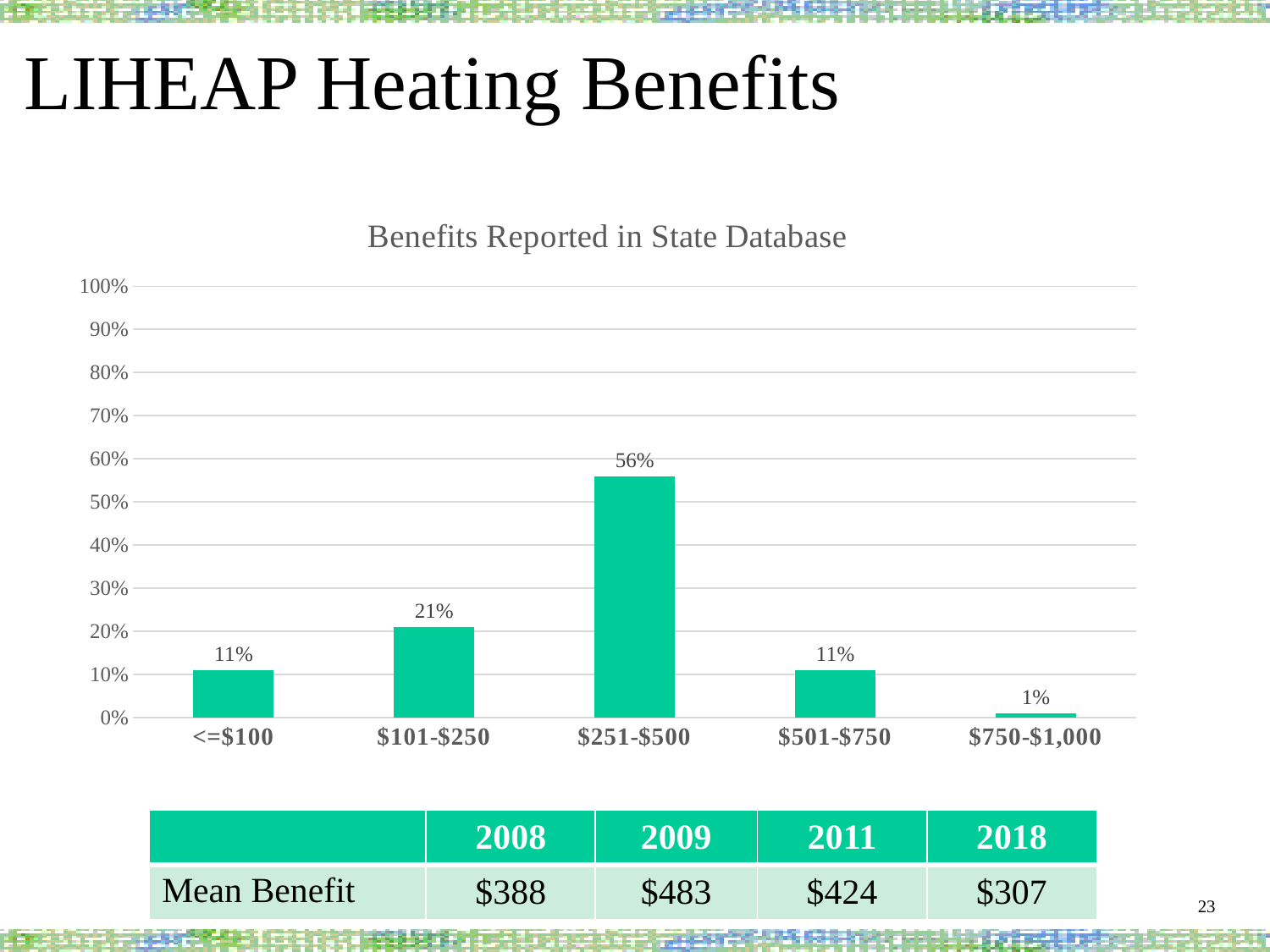
Which is larger, the value for $101-$250 or the value for $501-$750? $101-$250 Which benefit range has the lowest percentage? $750-$1,000 What is the difference in percentage points between the $251-$500 and $101-$250 categories? 35 Which benefit range has the highest percentage? $251-$500 Is the value for $251-$500 greater or less than 50%? greater What is the value shown for the <=$100 category? 11% What kind of chart is shown on the slide? Bar chart What is the value shown for the $750-$1,000 category? 1% What is the value shown for the $101-$250 category? 21% How many benefit range categories are shown on the x axis? 5 What is the title of the chart? Benefits Reported in State Database What percentage of benefits reported in the state database fall in the $251-$500 range? 56%